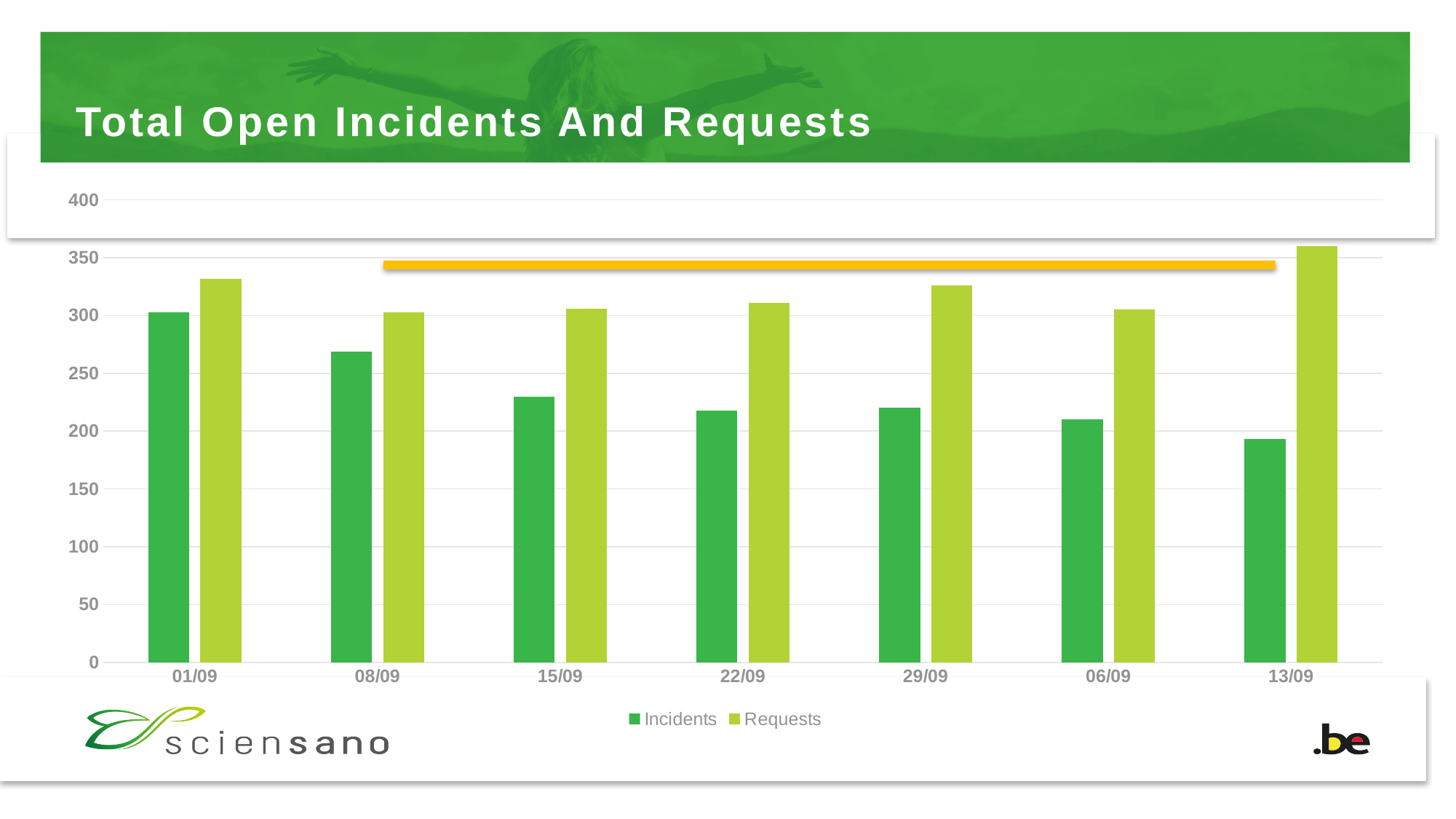
Is the value for Incidents on 08/09 greater or less than 250? greater Is the value for Requests on 13/09 greater or less than 350? greater Do the Incidents values generally rise or fall from 01/09 to 13/09? fall How many dates are shown along the x axis? 7 On 13/09, which is larger, Incidents or Requests? Requests What is the title of the chart? Total Open Incidents And Requests On which date are Incidents lowest? 13/09 On which date are Requests highest? 13/09 How many series does the legend list? 2 Is the value for Incidents on 13/09 greater or less than 200? less On which date are Incidents highest? 01/09 What kind of chart is shown on the slide? bar chart